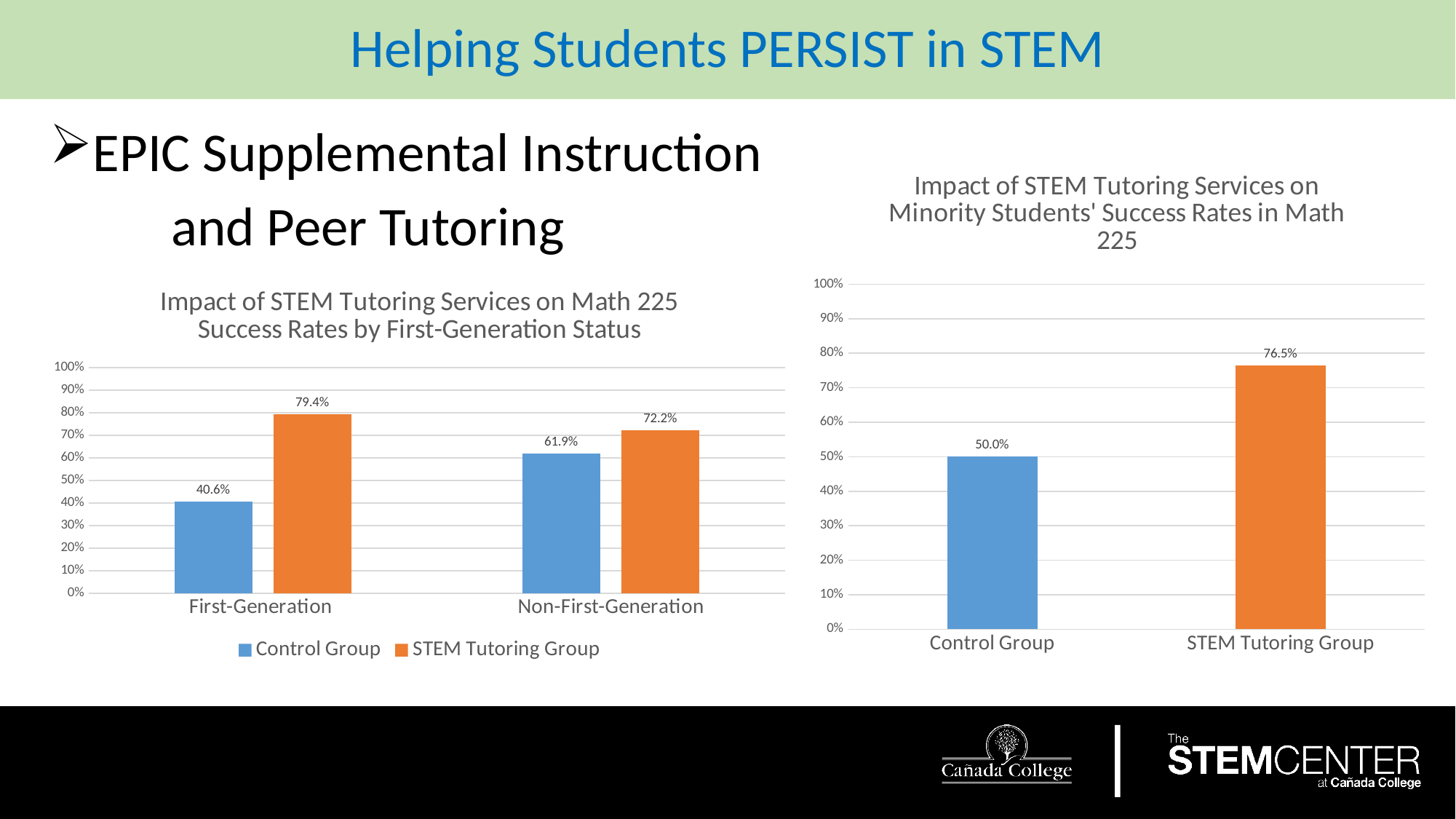
In the chart titled 'Impact of STEM Tutoring Services on Math 225 Success Rates by First-Generation Status', what is the value for the STEM Tutoring Group among Non-First-Generation students? 72.2% In the chart titled 'Impact of STEM Tutoring Services on Math 225 Success Rates by First-Generation Status', which bar is the highest? STEM Tutoring Group, First-Generation (79.4%) In the chart titled 'Impact of STEM Tutoring Services on Math 225 Success Rates by First-Generation Status', how many series does the legend list? 2 In the chart titled 'Impact of STEM Tutoring Services on Math 225 Success Rates by First-Generation Status', what colour represents the STEM Tutoring Group? Orange In the chart titled 'Impact of STEM Tutoring Services on Minority Students' Success Rates in Math 225', what is the difference between the STEM Tutoring Group and the Control Group? 26.5% In the chart titled 'Impact of STEM Tutoring Services on Math 225 Success Rates by First-Generation Status', which is larger: the Control Group value for First-Generation or for Non-First-Generation students? Non-First-Generation In the chart titled 'Impact of STEM Tutoring Services on Math 225 Success Rates by First-Generation Status', what is the value for the Control Group among First-Generation students? 40.6% In the chart titled 'Impact of STEM Tutoring Services on Minority Students' Success Rates in Math 225', how many categories are shown on the x axis? 2 In the chart titled 'Impact of STEM Tutoring Services on Minority Students' Success Rates in Math 225', what is the value for the Control Group? 50.0% In the chart titled 'Impact of STEM Tutoring Services on Minority Students' Success Rates in Math 225', what is the value for the STEM Tutoring Group? 76.5% In the chart titled 'Impact of STEM Tutoring Services on Math 225 Success Rates by First-Generation Status', what is the difference between the STEM Tutoring Group and the Control Group for First-Generation students? 38.8% What kind of chart is the one titled 'Impact of STEM Tutoring Services on Minority Students' Success Rates in Math 225'? Bar chart